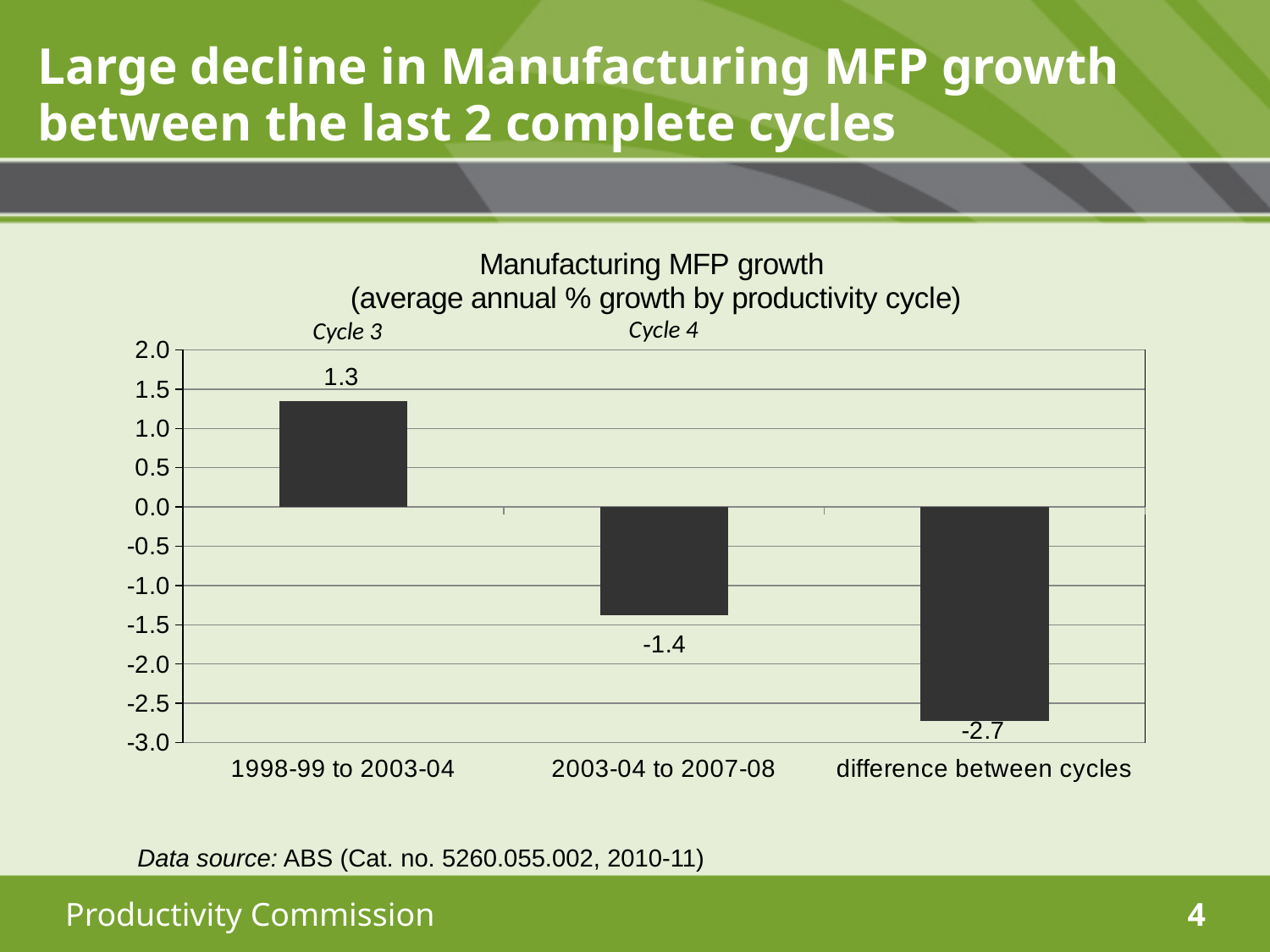
What is the value for 2003-04 to 2007-08? -1.4 What is the value for 1998-99 to 2003-04? 1.3 What is the difference between the values for 1998-99 to 2003-04 and 2003-04 to 2007-08? 2.7 Which category has the highest value? 1998-99 to 2003-04 Which cycle label is shown above the 1998-99 to 2003-04 bar? Cycle 3 What kind of chart is shown on the slide? bar chart Is the value for 2003-04 to 2007-08 greater or less than 0.0? less Which category has the lowest value? difference between cycles What is the title of the chart? Manufacturing MFP growth (average annual % growth by productivity cycle) Which is larger, the value for 2003-04 to 2007-08 or the value for 'difference between cycles'? 2003-04 to 2007-08 How many bars are shown in the chart? 3 What is the value for 'difference between cycles'? -2.7